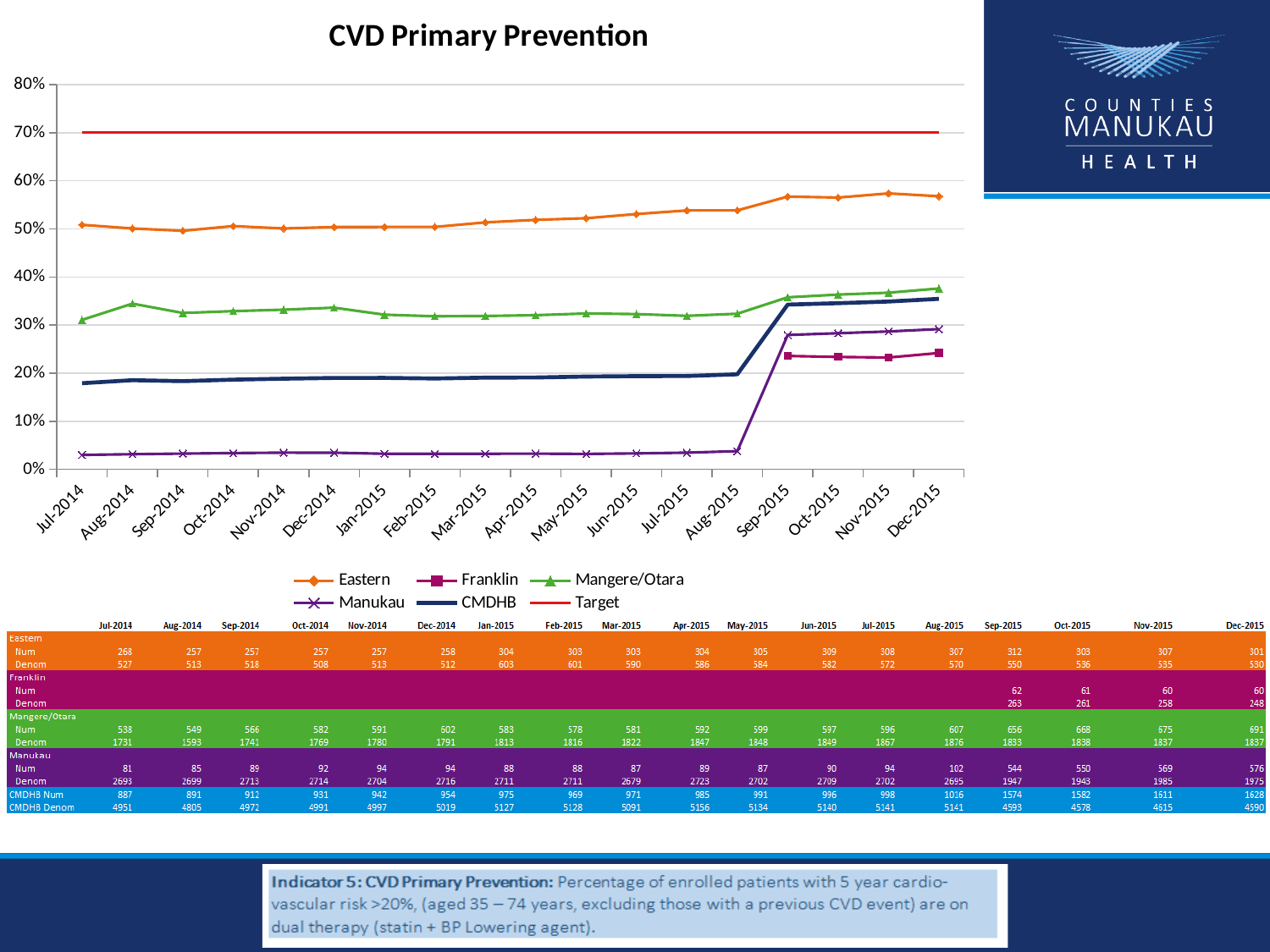
How many months are shown along the x axis of the chart? 18 In Dec-2015, which is larger: Eastern or Mangere/Otara? Eastern In Dec-2015, which is larger: CMDHB or Franklin? CMDHB What is the title of the chart? CVD Primary Prevention What value does the Target line sit at? 70% Is the value for Eastern in Dec-2015 greater or less than 50%? greater Is the value for Manukau in Jul-2014 greater or less than 10%? less What kind of chart is shown on the slide? line chart Is the value for Mangere/Otara in Dec-2015 greater or less than 30%? greater Which series has the lowest value in Jul-2014? Manukau How many series does the legend list? 6 Does the Manukau line rise or fall between Aug-2015 and Sep-2015? rise